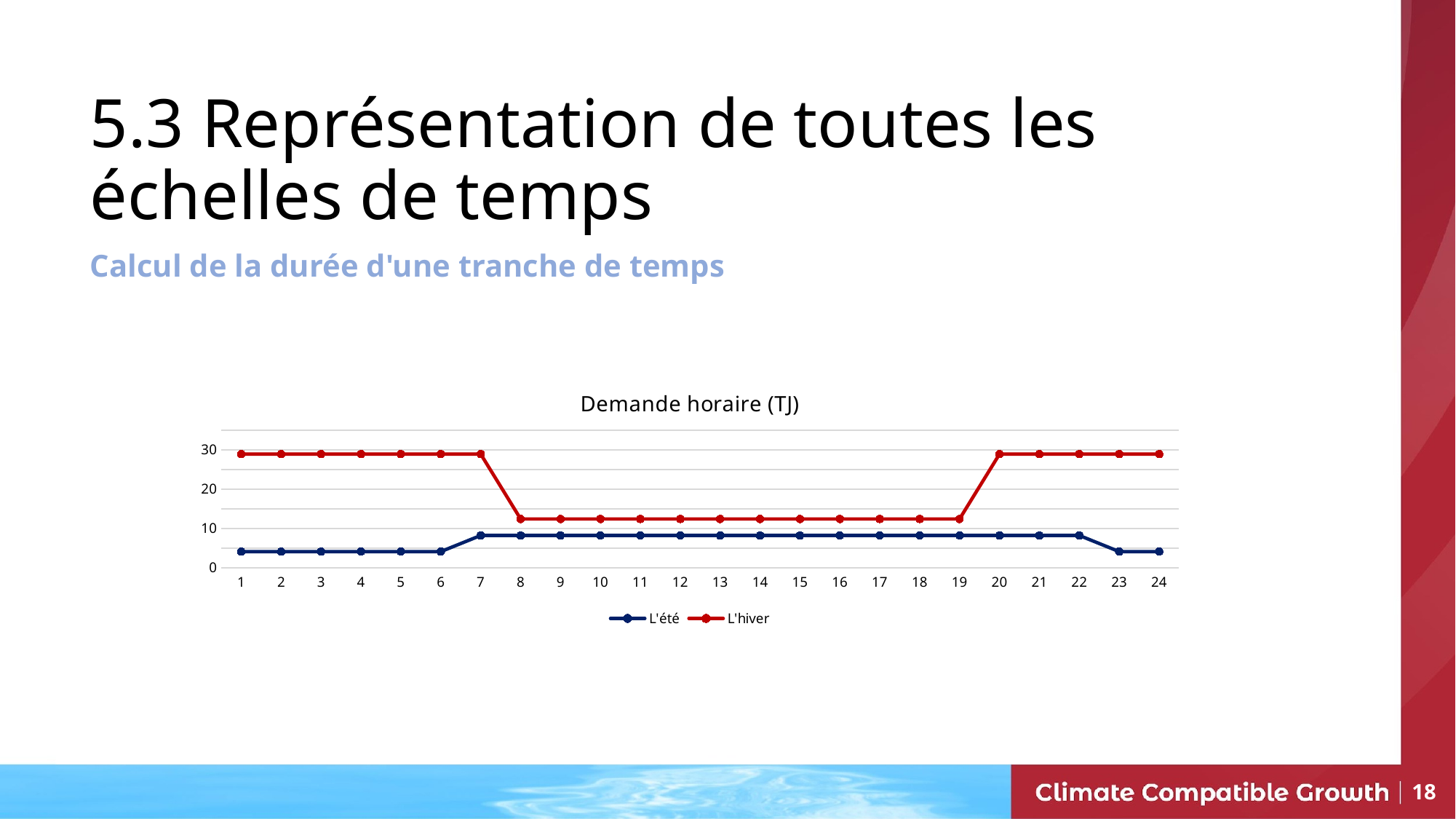
What kind of chart is shown on the slide? line chart Does the value for L'été rise or fall between hour 6 and hour 7? rise How many series does the legend list? 2 Is the value for L'hiver at hour 3 greater or less than 20? greater Is the value for L'été at hour 12 greater or less than 10? less Is the value for L'été at hour 2 greater or less than 10? less What is the title of the chart? Demande horaire (TJ) Does the value for L'hiver rise or fall between hour 7 and hour 8? fall Which colour is used for the L'hiver series? red How many points are plotted along the x axis for each series? 24 At hour 10, which series has the higher value, L'été or L'hiver? L'hiver